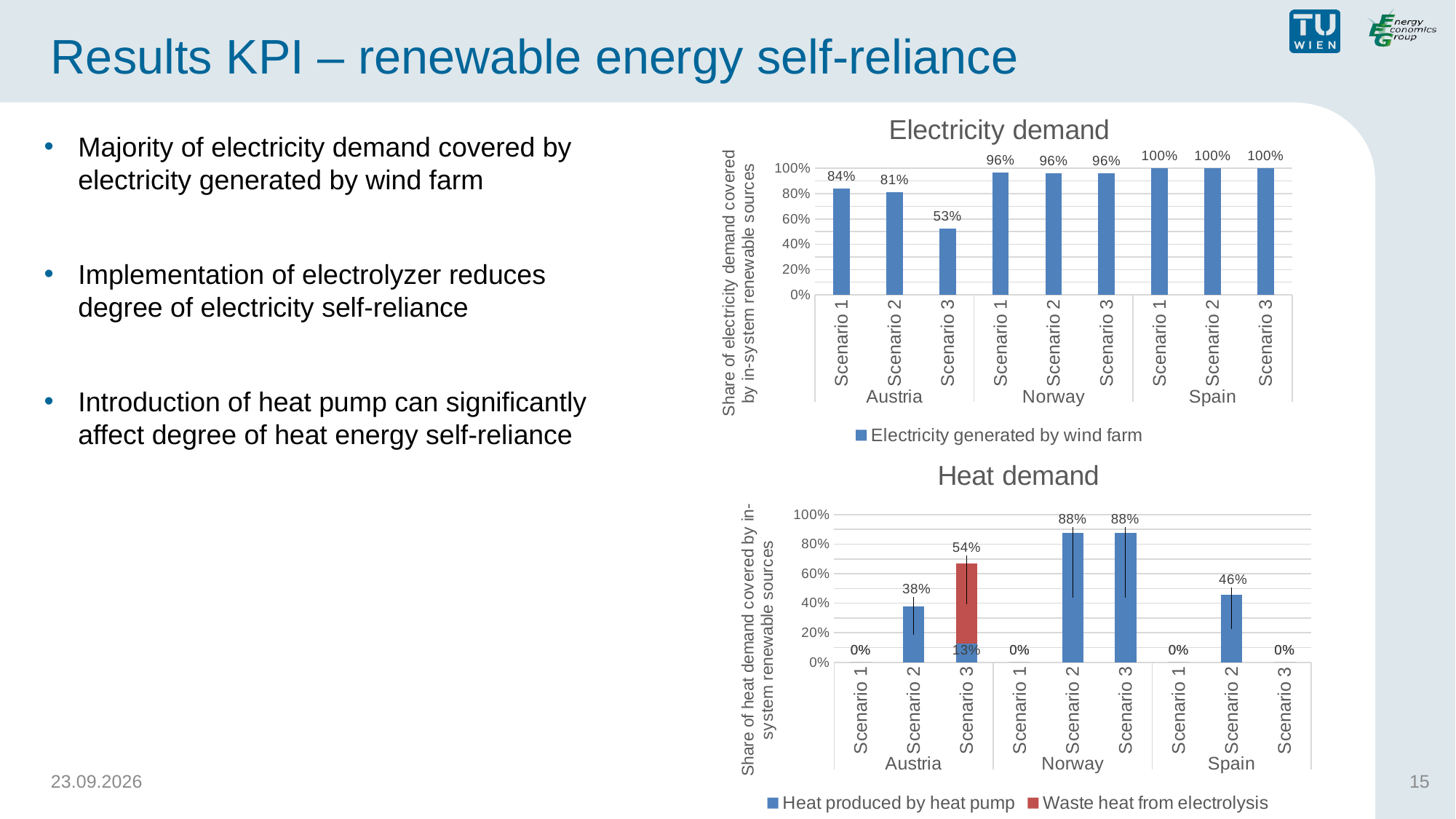
In the Heat demand chart, which is larger: Austria Scenario 2 or Spain Scenario 2? Spain Scenario 2 In the Electricity demand chart, what is the value for Austria Scenario 1? 84% In the Electricity demand chart, which country has the lowest value across its scenarios? Austria (Scenario 3) In the Electricity demand chart, what series does the legend list? Electricity generated by wind farm In the Electricity demand chart, what is the value for Norway Scenario 2? 96% In the Electricity demand chart, what is the difference between Austria Scenario 1 and Austria Scenario 3? 31% In the Heat demand chart, what is the value for Spain Scenario 2? 46% In the Electricity demand chart, how many bars are plotted? 9 In the Heat demand chart, how many series does the legend list? 2 In the Heat demand chart, what is the value for Norway Scenario 3? 88% In the Electricity demand chart, what is the value for Austria Scenario 3? 53% What type of chart is the Heat demand chart? Bar chart